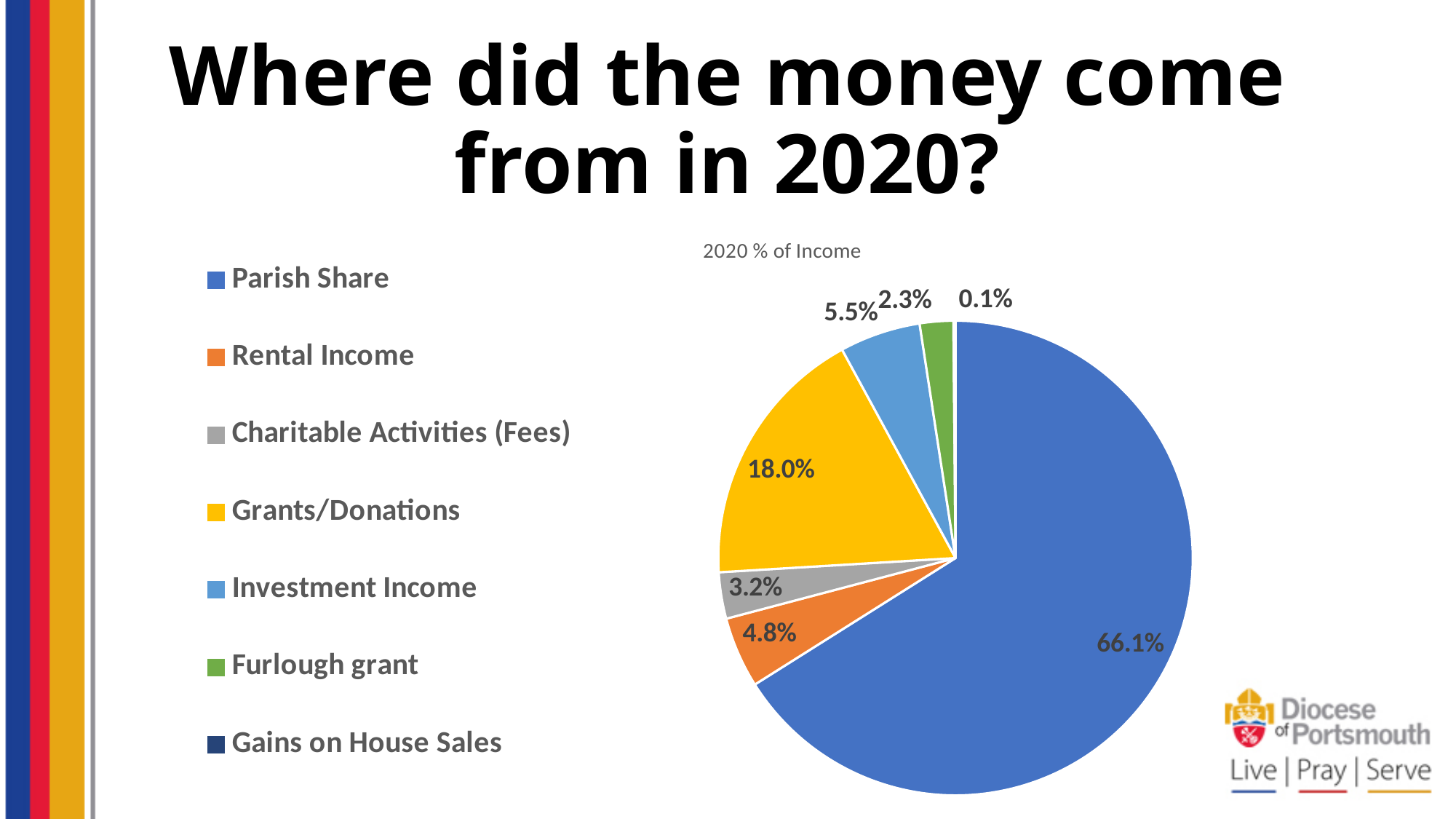
What share of 2020 income came from Grants/Donations? 18.0% What is the difference in percentage points between Grants/Donations and Investment Income? 12.5 What share of 2020 income came from Parish Share? 66.1% What share of 2020 income came from the Furlough grant? 2.3% What type of chart is shown on the slide? Pie chart What is the title of the chart? 2020 % of Income Which income source has the smallest share of the pie? Gains on House Sales Which income source has the largest share of the pie? Parish Share What share of 2020 income came from Investment Income? 5.5% What share of 2020 income came from Rental Income? 4.8% What share of 2020 income came from Charitable Activities (Fees)? 3.2% How many income categories does the legend list? 7